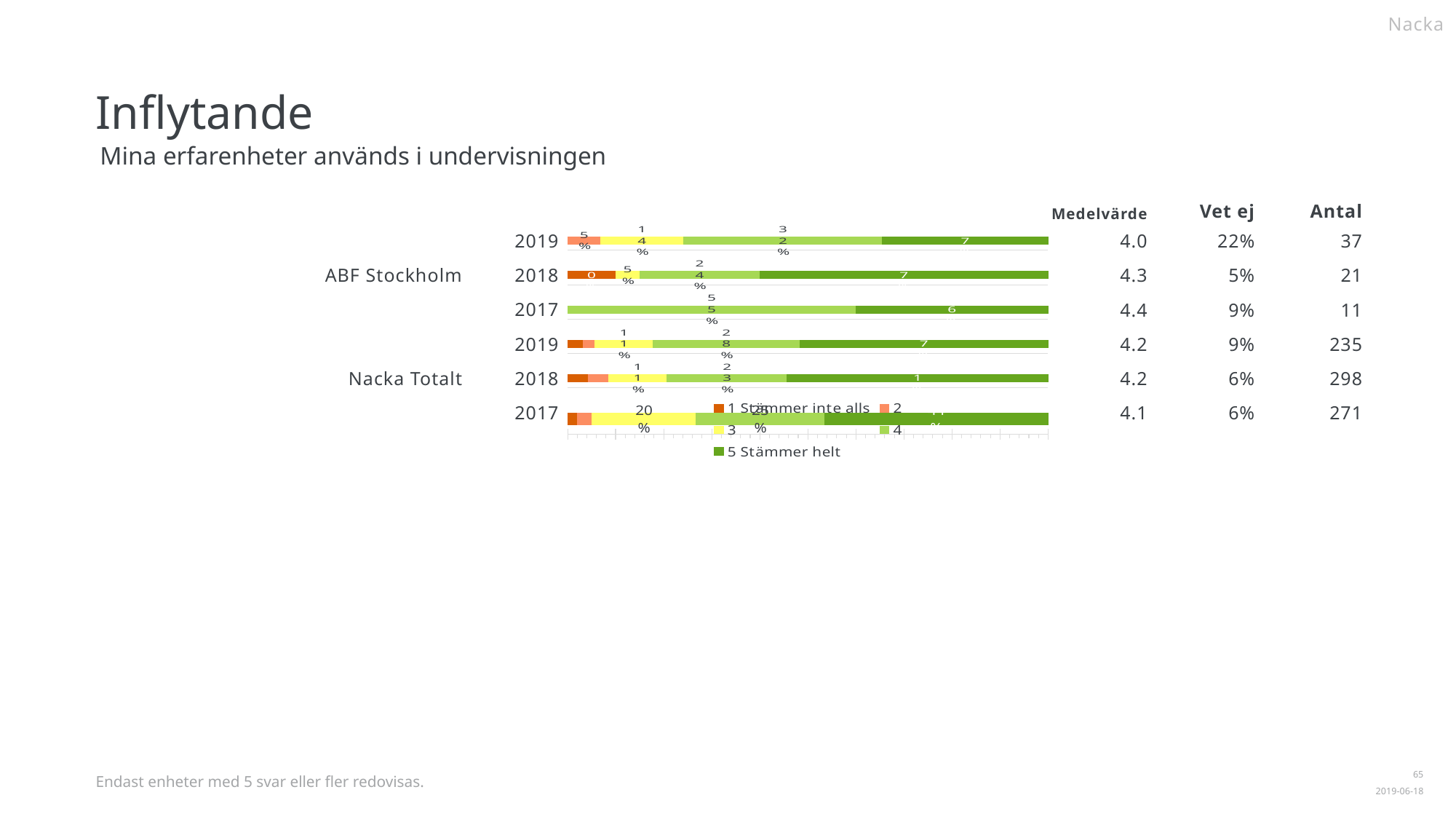
Which bar has the largest '5 Stämmer helt' segment? ABF Stockholm 2018 Is the '5 Stämmer helt' segment larger for ABF Stockholm 2018 or for ABF Stockholm 2019? ABF Stockholm 2018 What is the last legend entry in the chart? 5 Stämmer helt Which row has the highest Medelvärde? ABF Stockholm 2017 What kind of chart is shown on the slide? Stacked bar chart How many bars are plotted in the chart? 6 Which bar contains only two segments (no segments for 1, 2 or 3)? ABF Stockholm 2017 What is the Medelvärde shown for ABF Stockholm 2019? 4.0 What is the first legend entry in the chart? 1 Stämmer inte alls What is the Vet ej value shown for ABF Stockholm 2019? 22% What is the Antal shown for Nacka Totalt 2018? 298 How many entries does the chart legend list? 5